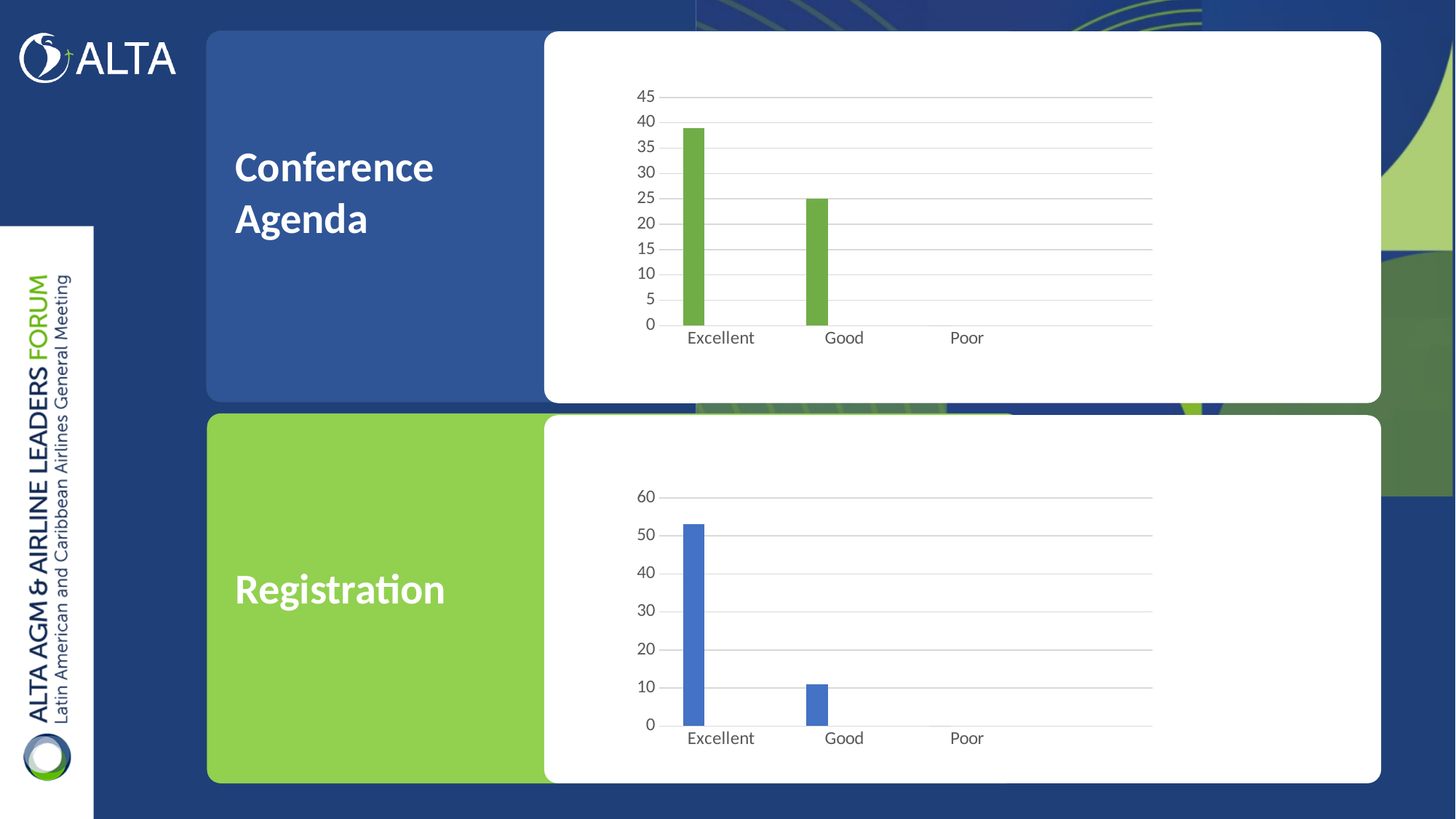
How many categories are shown on the x axis of the Conference Agenda chart? 3 In the Conference Agenda chart, which is larger, Excellent or Good? Excellent In the Registration chart, is the value for Excellent greater or less than 40? greater In the Conference Agenda chart, do the values rise or fall from Excellent to Poor? fall In the Conference Agenda chart, which category has the highest value? Excellent In the Conference Agenda chart, is the value for Good greater or less than 30? less In the Registration chart, is the value for Good greater or less than 20? less In the Registration chart, which category has the lowest value? Poor What colour are the bars in the Registration chart? blue What kind of chart is the Conference Agenda chart? bar chart In the Registration chart, which category has the highest value? Excellent